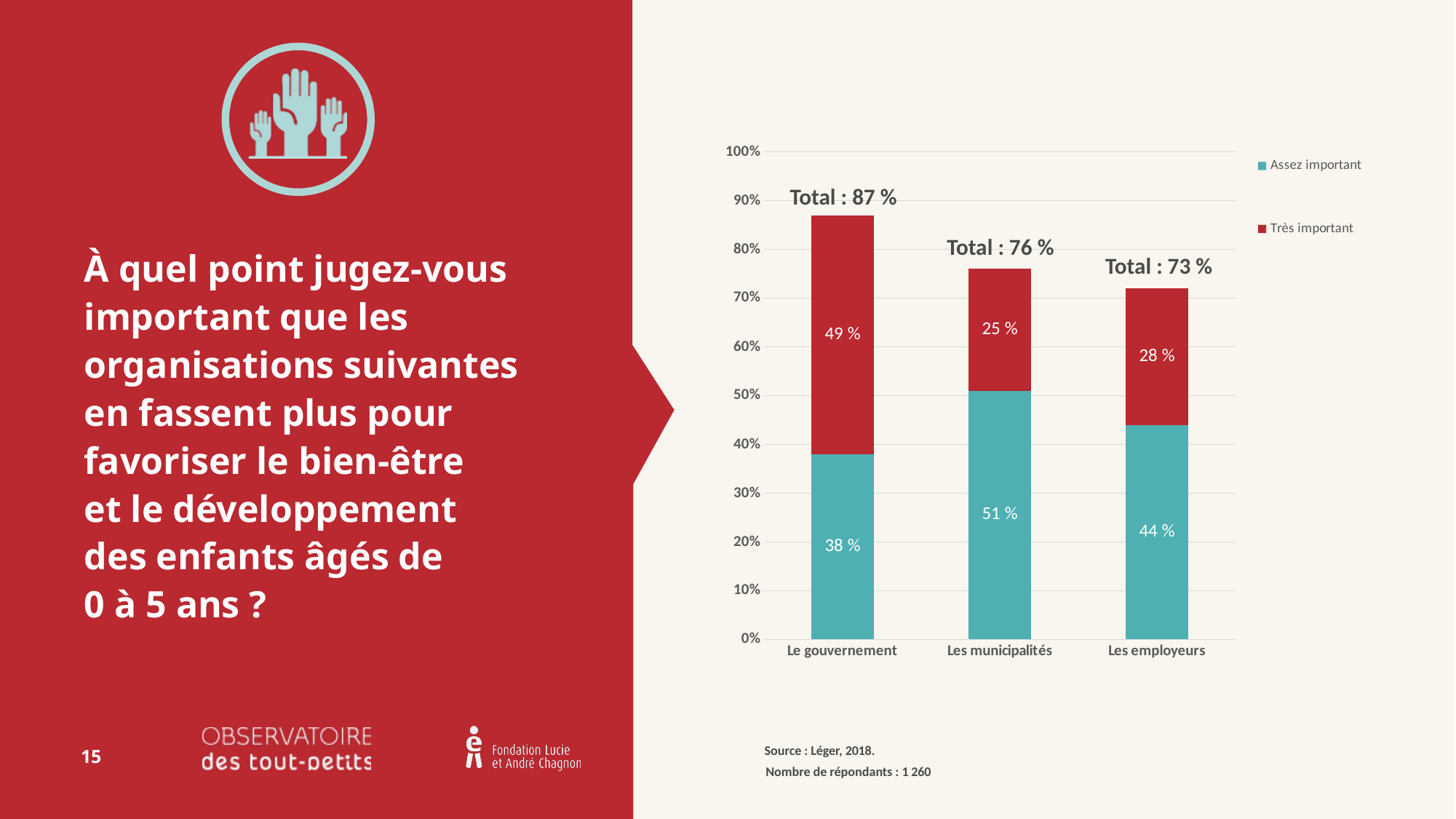
Which category has the highest 'Assez important' value? Les municipalités How many series does the legend list? 2 What is the total of the stacked bar for Les municipalités? 76 % What is the 'Très important' value for Le gouvernement? 49 % How many categories are shown on the x axis? 3 What is the 'Très important' value for Les employeurs? 28 % Which is larger: the 'Assez important' value for Le gouvernement or for Les employeurs? Les employeurs Which category has the highest stacked total? Le gouvernement What is the difference between the 'Très important' values for Le gouvernement and Les employeurs? 21 % What is the 'Assez important' value for Les municipalités? 51 % Which category has the lowest 'Très important' value? Les municipalités What kind of chart is shown on the slide? Stacked bar chart